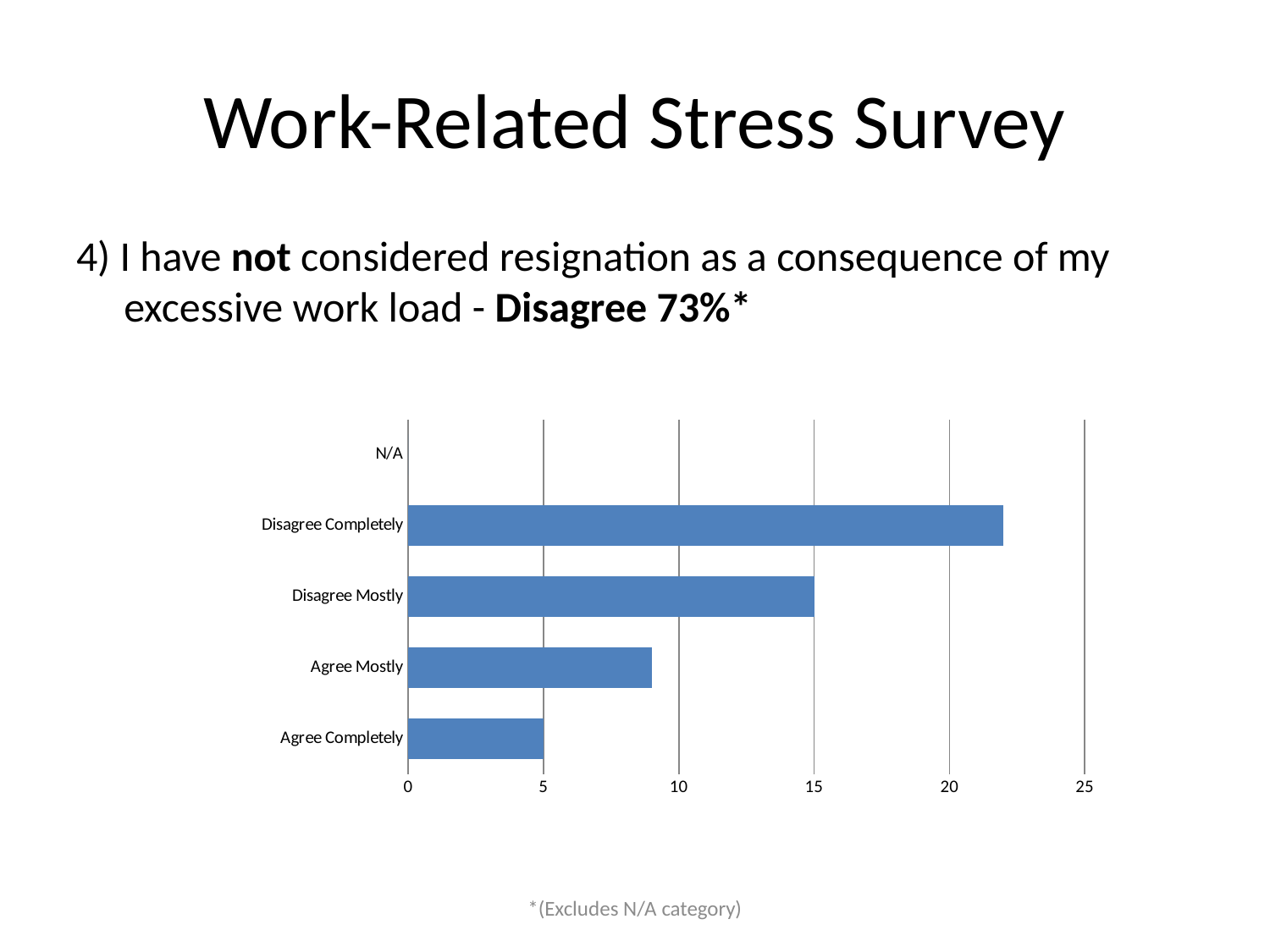
What kind of chart is shown on the slide? bar chart What is the difference between the values for Disagree Mostly and Agree Completely? 10 Is the value for Agree Mostly greater or less than 10? less Excluding N/A, which category has the shortest bar in the chart? Agree Completely Is the value for Agree Mostly greater or less than 5? greater Which is larger, the value for Disagree Mostly or the value for Agree Mostly? Disagree Mostly What is the value for Disagree Mostly? 15 What is the highest tick value shown on the chart's horizontal axis? 25 Which category has the longest bar in the chart? Disagree Completely How many categories are shown on the chart's vertical axis? 5 Is the value for Disagree Completely greater or less than 20? greater What is the value for Agree Completely? 5